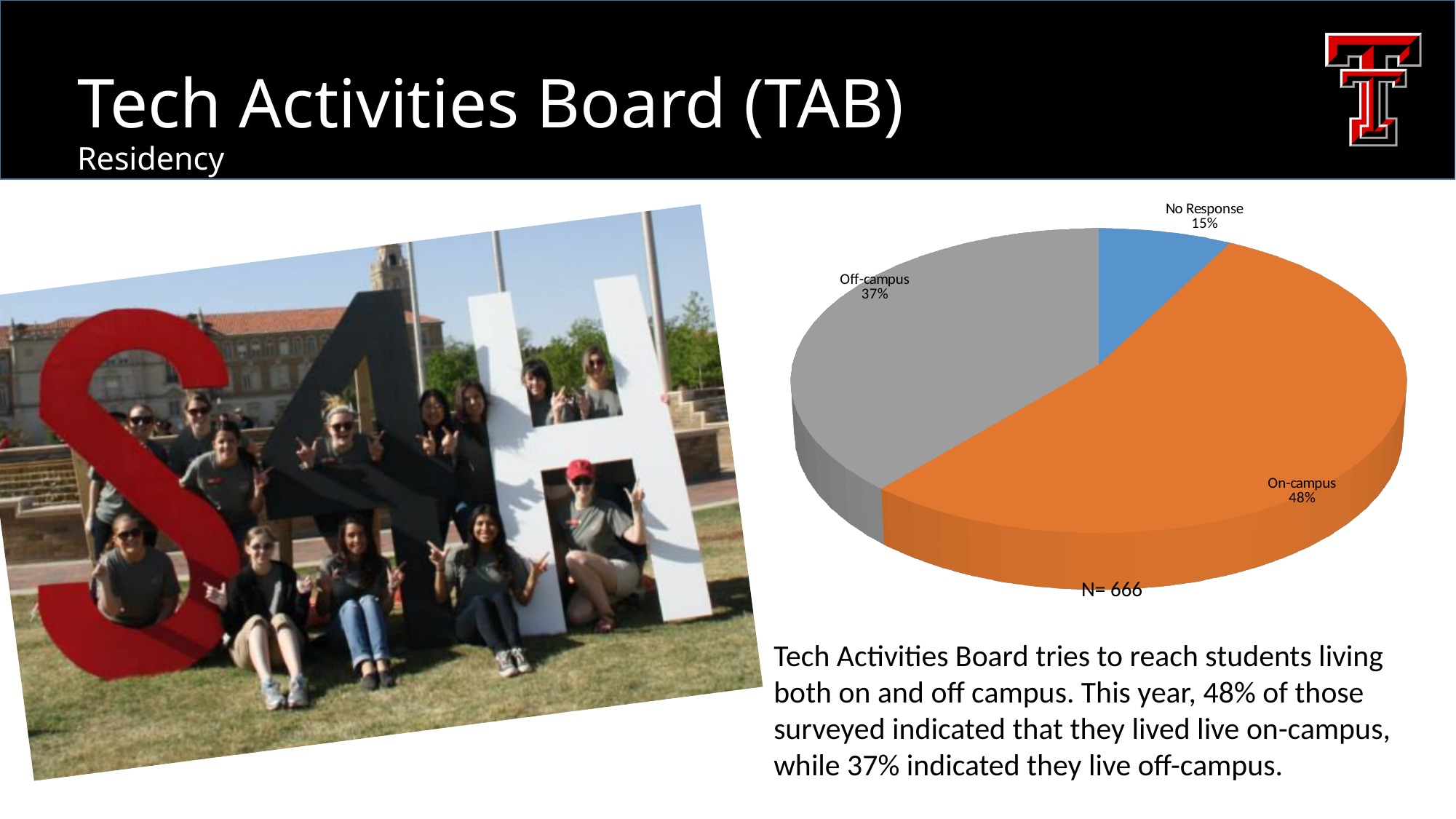
Which is larger, the Off-campus share or the No Response share? Off-campus Which category has the largest slice of the pie? On-campus What percentage of respondents live off-campus? 37% What percentage of respondents live on-campus? 48% What is the difference in percentage points between Off-campus and No Response? 22 Which category has the smallest slice of the pie? No Response What kind of chart is shown on the slide? Pie chart What is the N value shown below the pie chart? N= 666 How many categories are shown in the pie chart? 3 What is the difference in percentage points between On-campus and Off-campus? 11 What colour is the On-campus slice? Orange What share of the pie is labelled No Response? 15%